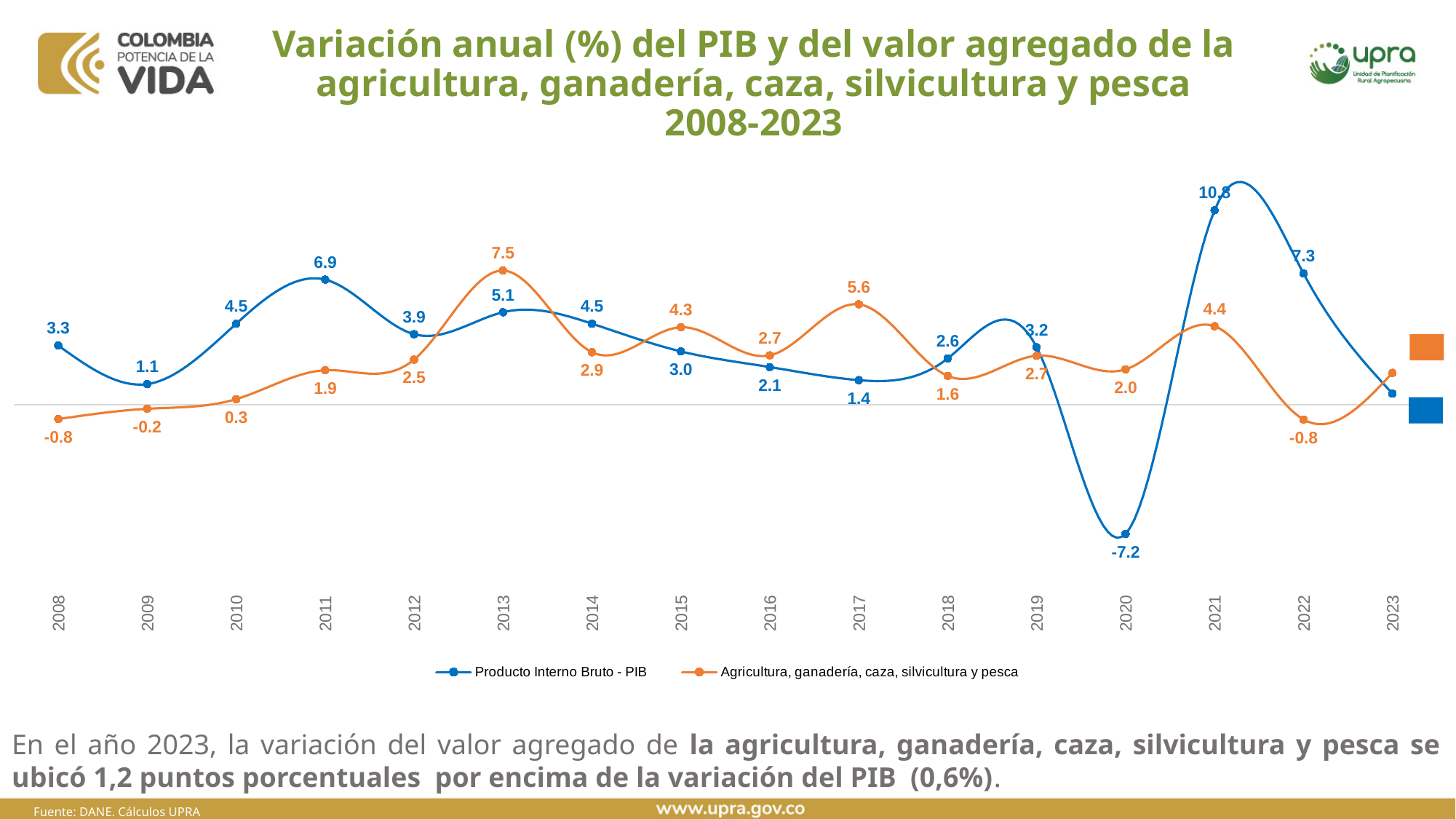
Does the Agricultura, ganadería, caza, silvicultura y pesca series rise or fall from 2008 to 2013? Rise What type of chart is shown on the slide? Line chart In which year does the Producto Interno Bruto - PIB series reach its lowest value? 2020 What is the value for Producto Interno Bruto - PIB in 2011? 6.9 How many series does the legend list? 2 How many years are plotted along the x axis? 16 What is the difference between the Agricultura, ganadería, caza, silvicultura y pesca value and the Producto Interno Bruto - PIB value in 2013? 2.4 In which year does the Agricultura, ganadería, caza, silvicultura y pesca series reach its highest value? 2013 What is the value for Producto Interno Bruto - PIB in 2020? -7.2 Which series has the larger value in 2022, Producto Interno Bruto - PIB or Agricultura, ganadería, caza, silvicultura y pesca? Producto Interno Bruto - PIB What is the value for Agricultura, ganadería, caza, silvicultura y pesca in 2017? 5.6 In which year does the Producto Interno Bruto - PIB series reach its highest value? 2021